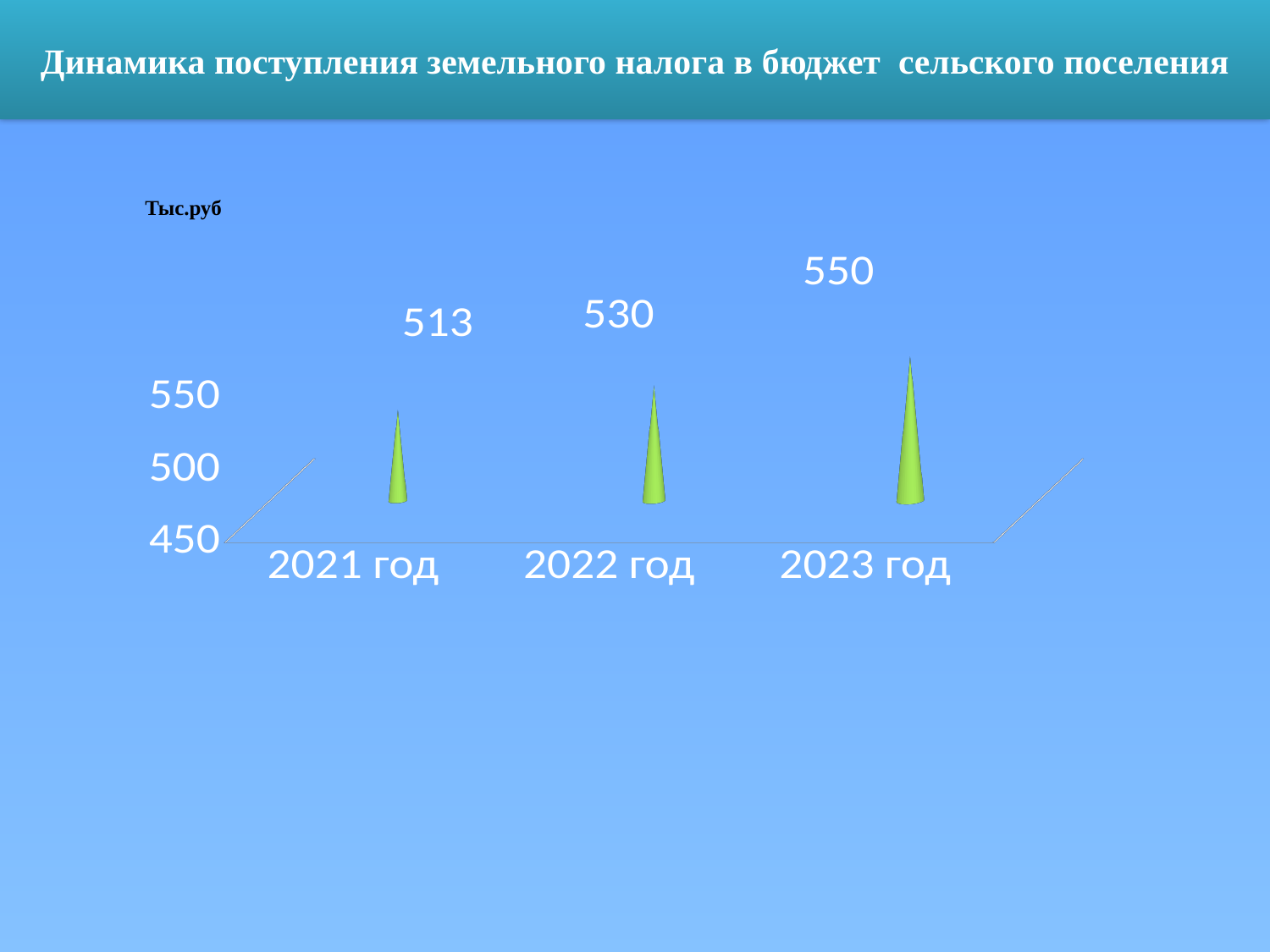
What is the value for 2021 год? 513 What is the difference between the values for 2023 год and 2021 год? 37 What is the value for 2022 год? 530 Which year has the lowest value? 2021 год What is the value for 2023 год? 550 Which year has the highest value? 2023 год Do the values rise or fall from 2021 год to 2023 год? rise What is the difference between the values for 2022 год and 2021 год? 17 How many years are shown on the chart? 3 Which is larger, the value for 2022 год or the value for 2023 год? 2023 год What unit is indicated for the values on the chart? Тыс.руб Is the value for 2021 год greater or less than 500? greater